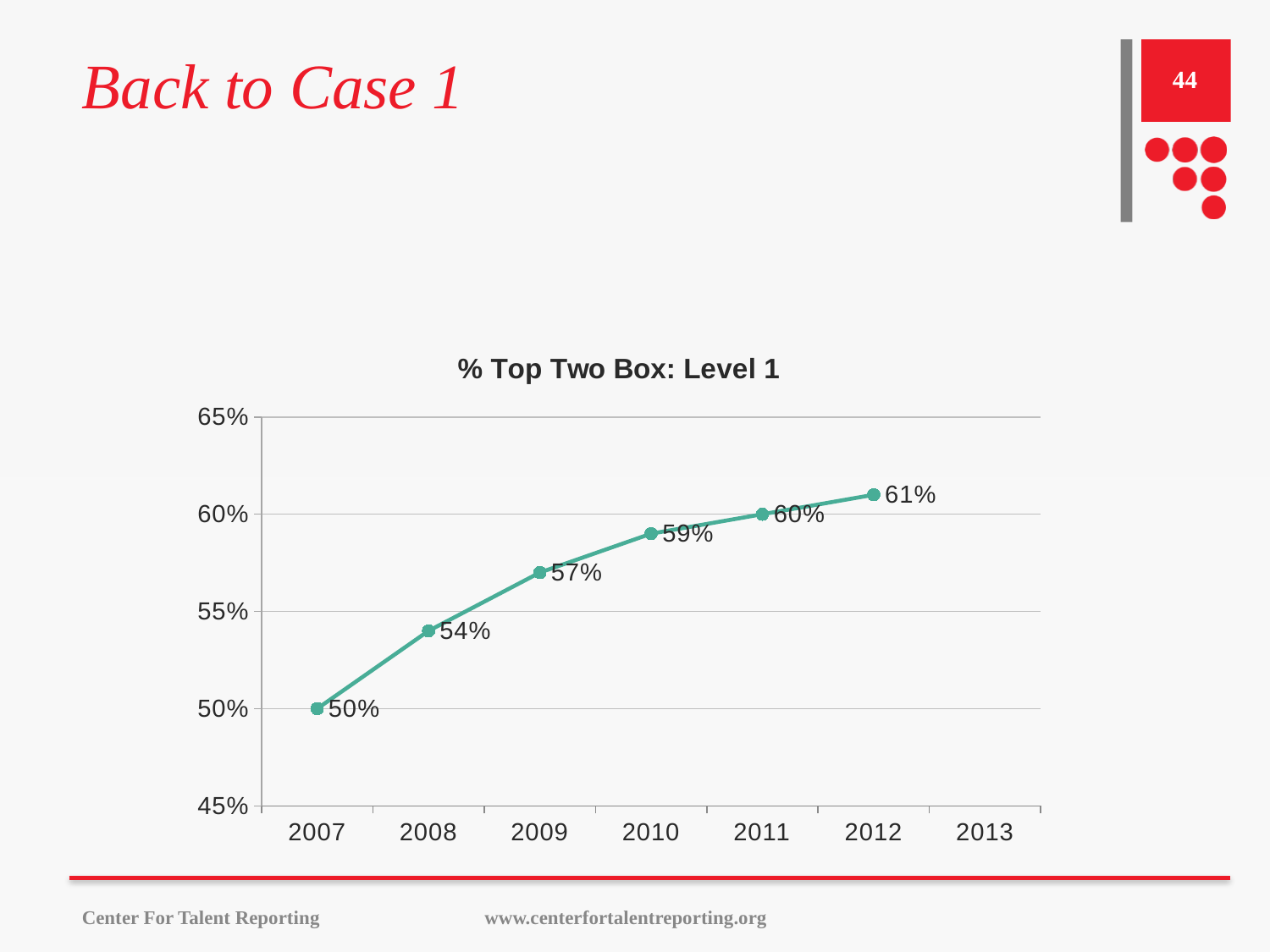
Which year has the highest value? 2012 What is the difference between the values for 2012 and 2007? 11% Which year has the lowest value? 2007 What is the value for 2009? 57% What kind of chart is shown? line chart Is the value for 2011 greater or less than 55%? greater What is the difference between the values for 2008 and 2009? 3% Which is larger, the value for 2010 or the value for 2008? 2010 What is the value for 2012? 61% What is the value for 2007? 50% How many data points are plotted on the line? 6 Do the values rise or fall from 2007 to 2012? rise